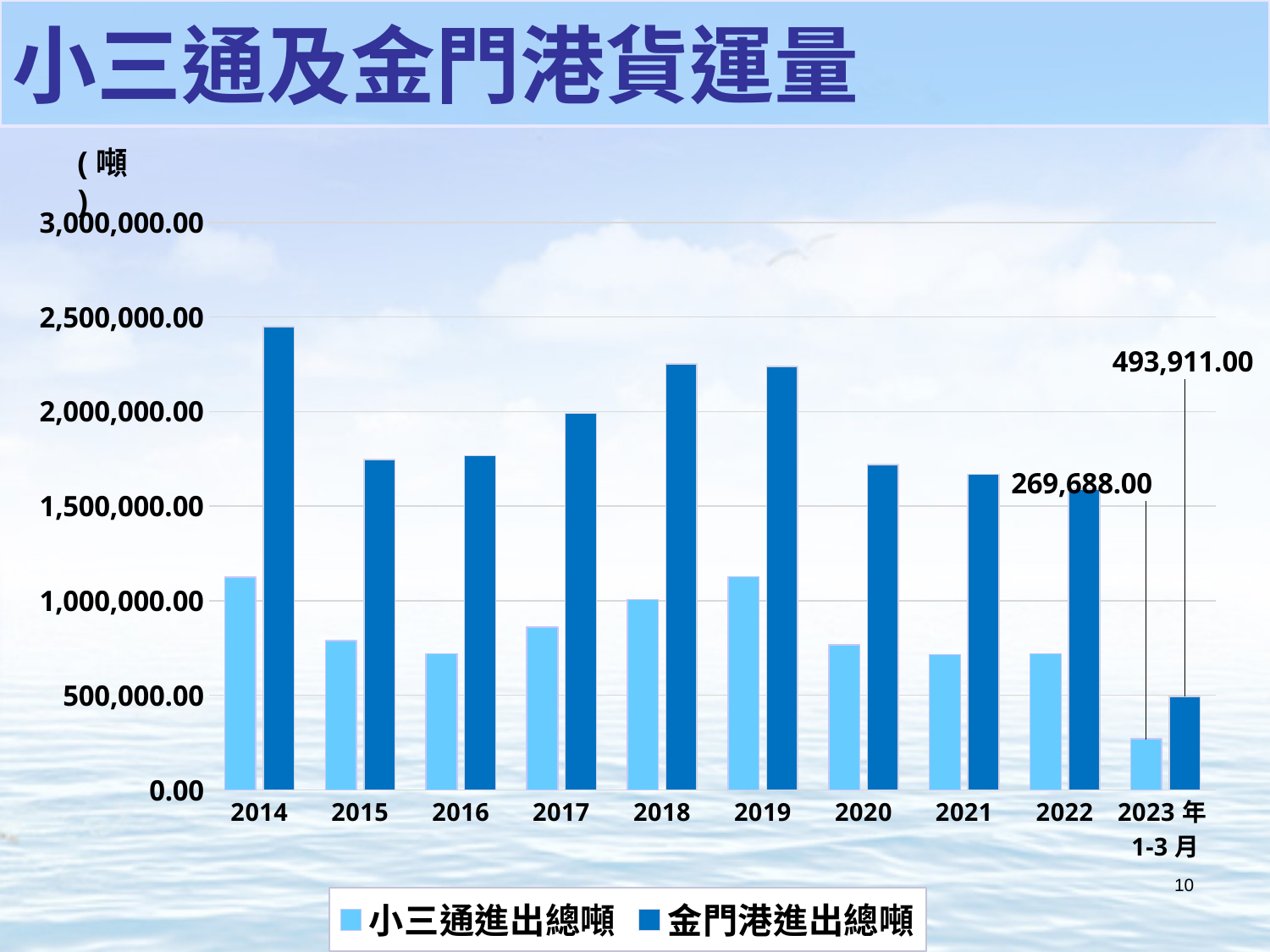
In which year is 金門港進出總噸 the highest? 2014 Does 金門港進出總噸 rise or fall from 2019 to 2022? fall What is the value of 金門港進出總噸 for 2023年1-3月? 493,911.00 How many series does the legend list? 2 Which is larger for 金門港進出總噸: 2014 or 2018? 2014 How many categories are shown on the x axis? 10 What is the difference between 金門港進出總噸 and 小三通進出總噸 for 2023年1-3月? 224,223.00 What kind of chart is shown on the slide? bar chart Is the value of 金門港進出總噸 for 2014 greater or less than 2,000,000.00? greater What is the value of 小三通進出總噸 for 2023年1-3月? 269,688.00 Is the value of 小三通進出總噸 for 2015 greater or less than 1,000,000.00? less Which category has the lowest value for 金門港進出總噸? 2023年1-3月